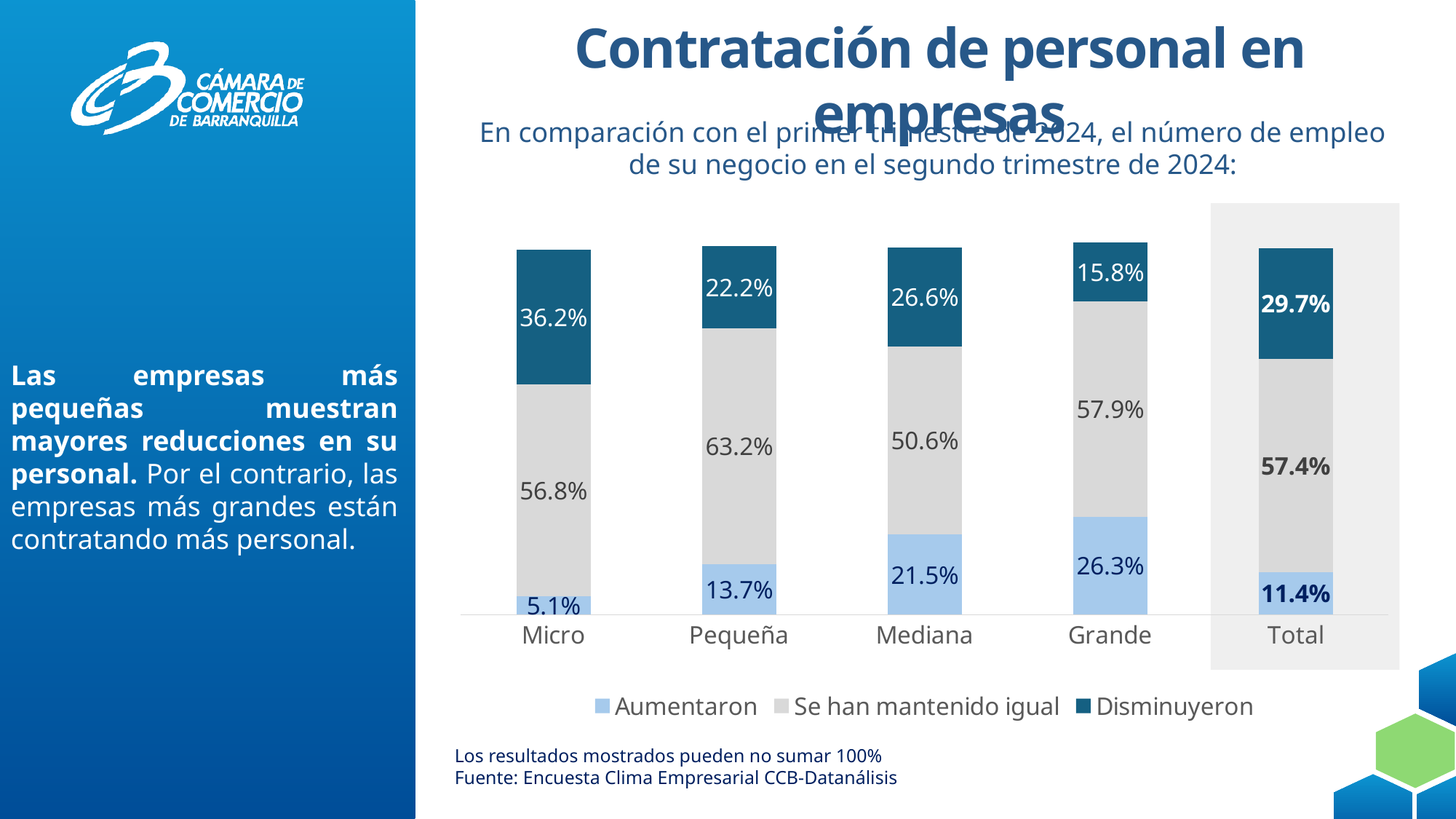
Which is larger: the 'Se han mantenido igual' value for Pequeña or for Mediana? Pequeña What is the 'Se han mantenido igual' value for Grande companies? 57.9% Which category has the highest 'Disminuyeron' value? Micro How many series does the legend list? 3 How many categories are shown on the x axis? 5 Does the 'Aumentaron' value rise or fall from Micro to Grande? Rise Which category has the lowest 'Aumentaron' value? Micro What is the 'Aumentaron' value for the Total category? 11.4% What percentage of Micro companies reported that employment 'Aumentaron'? 5.1% What is the 'Disminuyeron' value for Pequeña companies? 22.2% What kind of chart is shown on the slide? Stacked bar chart What is the difference between the 'Aumentaron' values for Grande and Micro? 21.2%